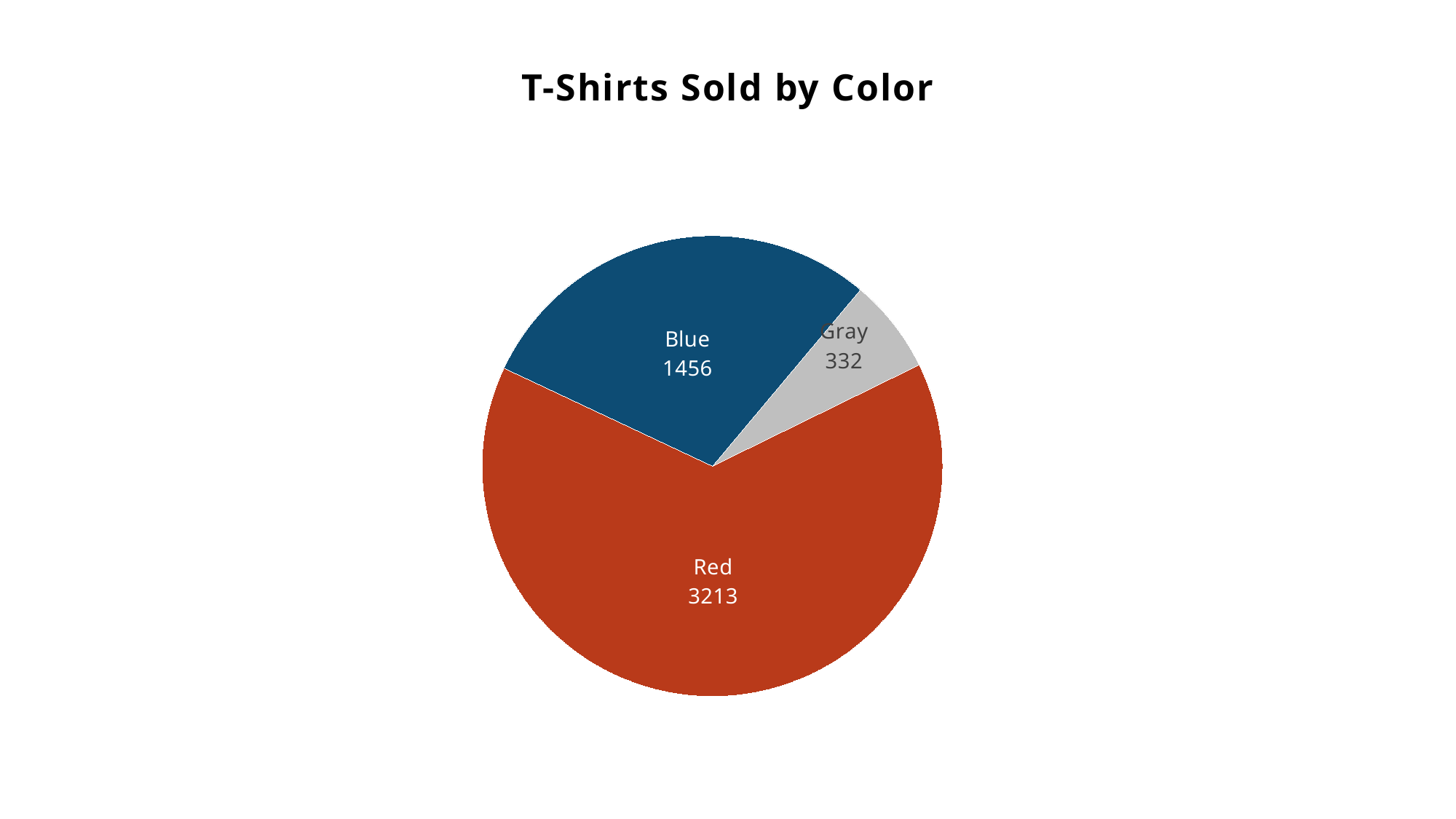
What kind of chart is shown on the slide? Pie chart How many T-shirts were sold in Blue? 1456 What is the difference between the number of Blue and Gray T-shirts sold? 1124 Which sold more T-shirts, Blue or Gray? Blue How many T-shirts were sold in Red? 3213 Which color has the largest number of T-shirts sold? Red What is the difference between the number of Red and Blue T-shirts sold? 1757 Which color has the smallest number of T-shirts sold? Gray What is the title of the chart? T-Shirts Sold by Color How many T-shirts were sold in Gray? 332 How many color categories are shown in the pie chart? 3 What is the total number of T-shirts sold across all colors? 5001